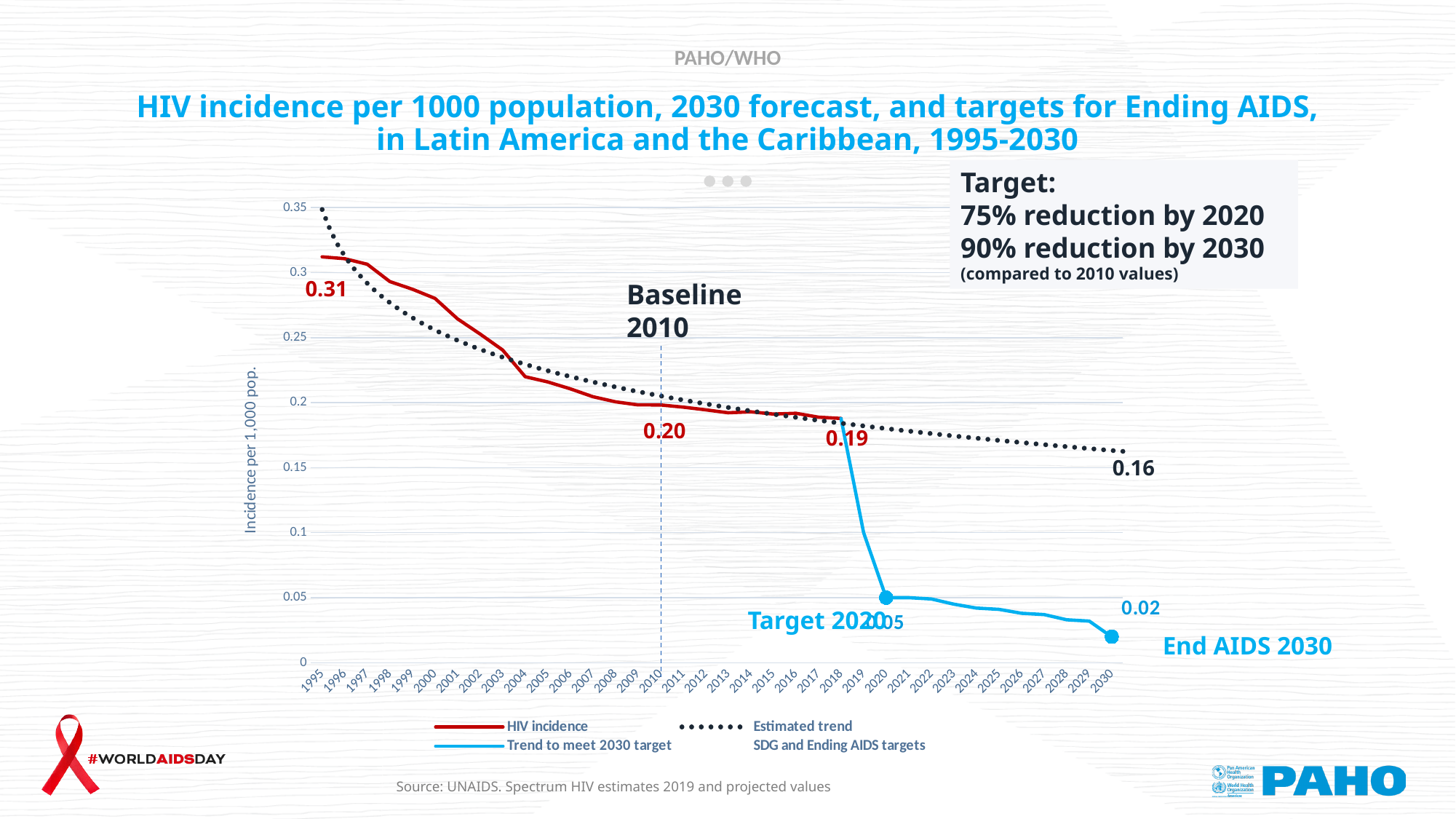
Does the HIV incidence line rise or fall from 1995 to 2018? Fall What is the HIV incidence per 1000 population in 1995? 0.31 How many series does the legend list? 4 What kind of chart is shown on the slide? Line chart What is the Target 2020 value on the trend to meet the 2030 target? 0.05 Which is larger in 2030: the estimated trend value or the End AIDS target value? Estimated trend What is the End AIDS 2030 target value? 0.02 What is the HIV incidence value at the 2010 baseline? 0.20 What is the HIV incidence value labelled for 2018? 0.19 What value does the estimated trend reach in 2030? 0.16 By how much did HIV incidence fall from 1995 (0.31) to the 2010 baseline (0.20)? 0.11 What is the difference between the 2030 estimated trend value (0.16) and the End AIDS 2030 target (0.02)? 0.14